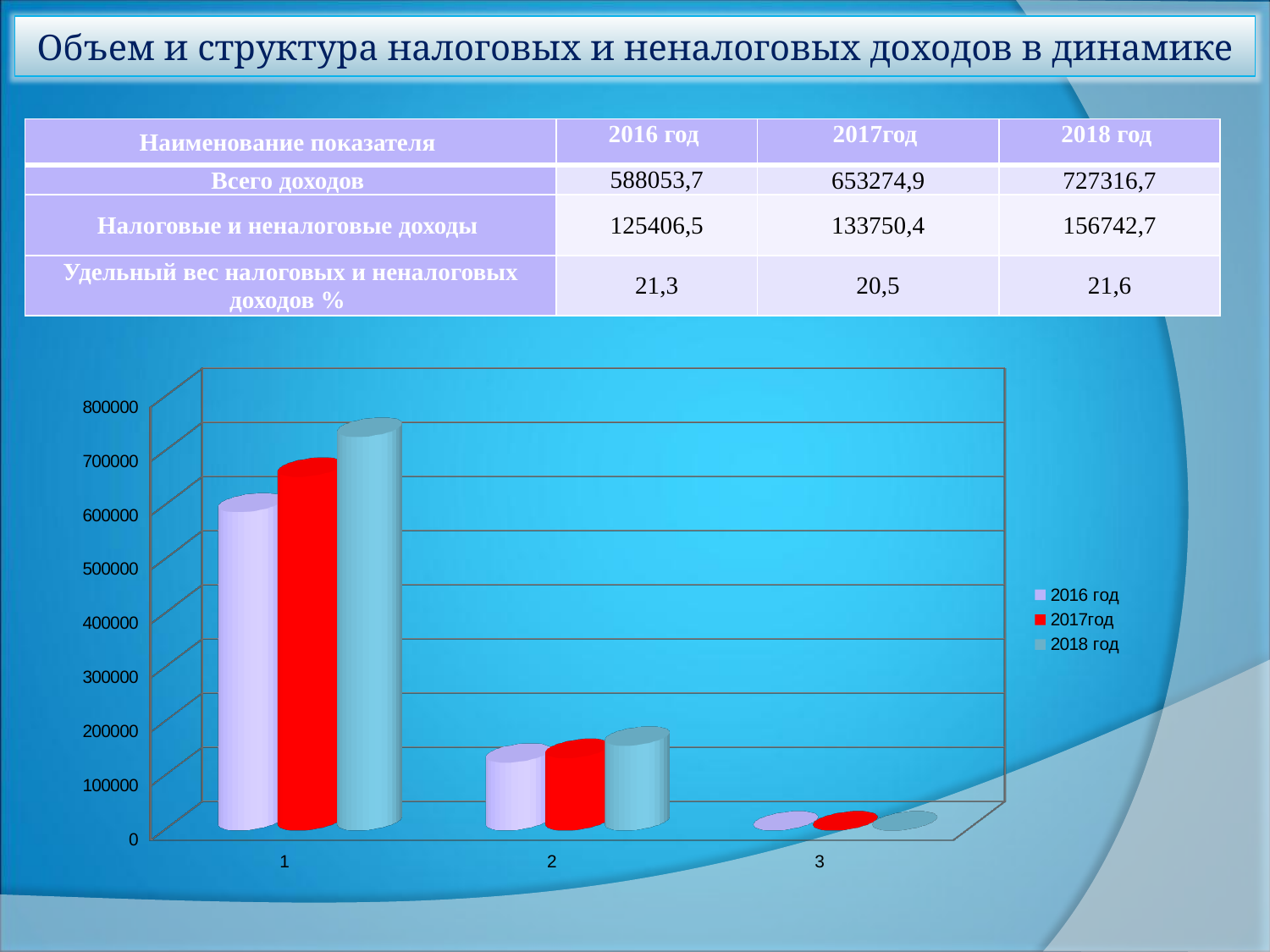
Which is larger in category 2: the bar for 2016 год or the bar for 2018 год? 2018 год In category 1, which series has the lowest bar? 2016 год How many series does the chart legend list? 3 Is the value for 2017год in category 1 greater or less than 600000? greater Is the value for 2016 год in category 1 greater or less than 500000? greater In category 1, which series has the highest bar? 2018 год Which category has the lowest bars overall? 3 Is the value for 2018 год in category 2 greater or less than 200000? less How many categories are shown on the x axis of the chart? 3 Do the bars for category 1 rise or fall from 2016 год to 2018 год? rise What kind of chart is shown on the slide? bar chart